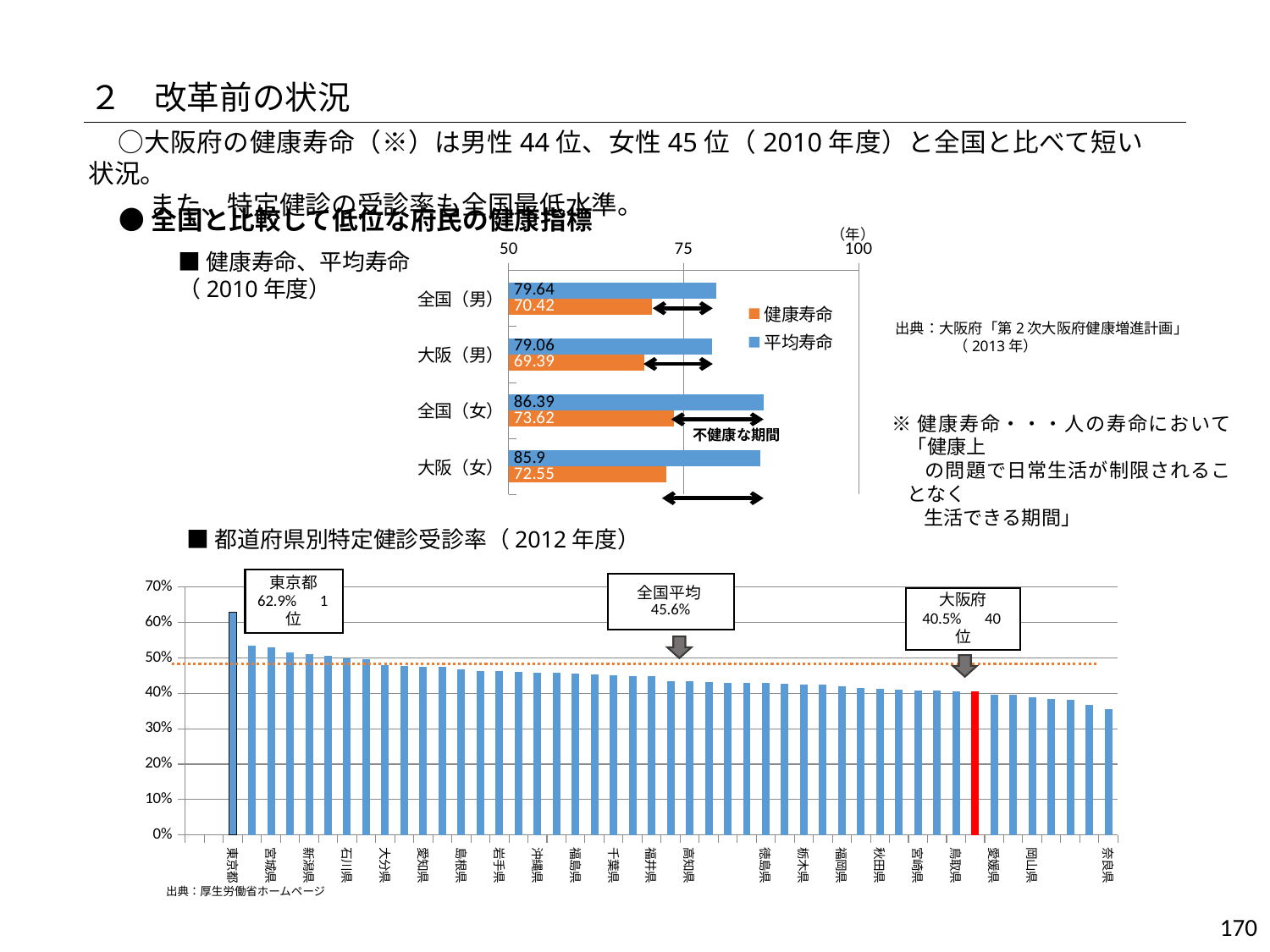
In the 健康寿命、平均寿命 chart, what is the 平均寿命 value for 全国（男）? 79.64 In the 健康寿命、平均寿命 chart, which category has the highest 平均寿命? 全国（女） What kind of chart is the 都道府県別特定健診受診率 chart? Bar chart In the 健康寿命、平均寿命 chart, what is the 健康寿命 value for 大阪（女）? 72.55 In the 都道府県別特定健診受診率 chart, is the value for 奈良県 greater or less than 40%? less In the 都道府県別特定健診受診率 chart, what is the difference between 東京都 and 大阪府? 22.4% In the 都道府県別特定健診受診率 chart, what is the value for 大阪府? 40.5% In the 健康寿命、平均寿命 chart, which has the higher 健康寿命, 全国（男） or 大阪（男）? 全国（男） In the 健康寿命、平均寿命 chart, what is the difference between 平均寿命 and 健康寿命 for 全国（男）? 9.22 How many series does the legend of the 健康寿命、平均寿命 chart list? 2 In the 都道府県別特定健診受診率 chart, what is the value for 東京都? 62.9% How many categories are shown in the 健康寿命、平均寿命 chart? 4